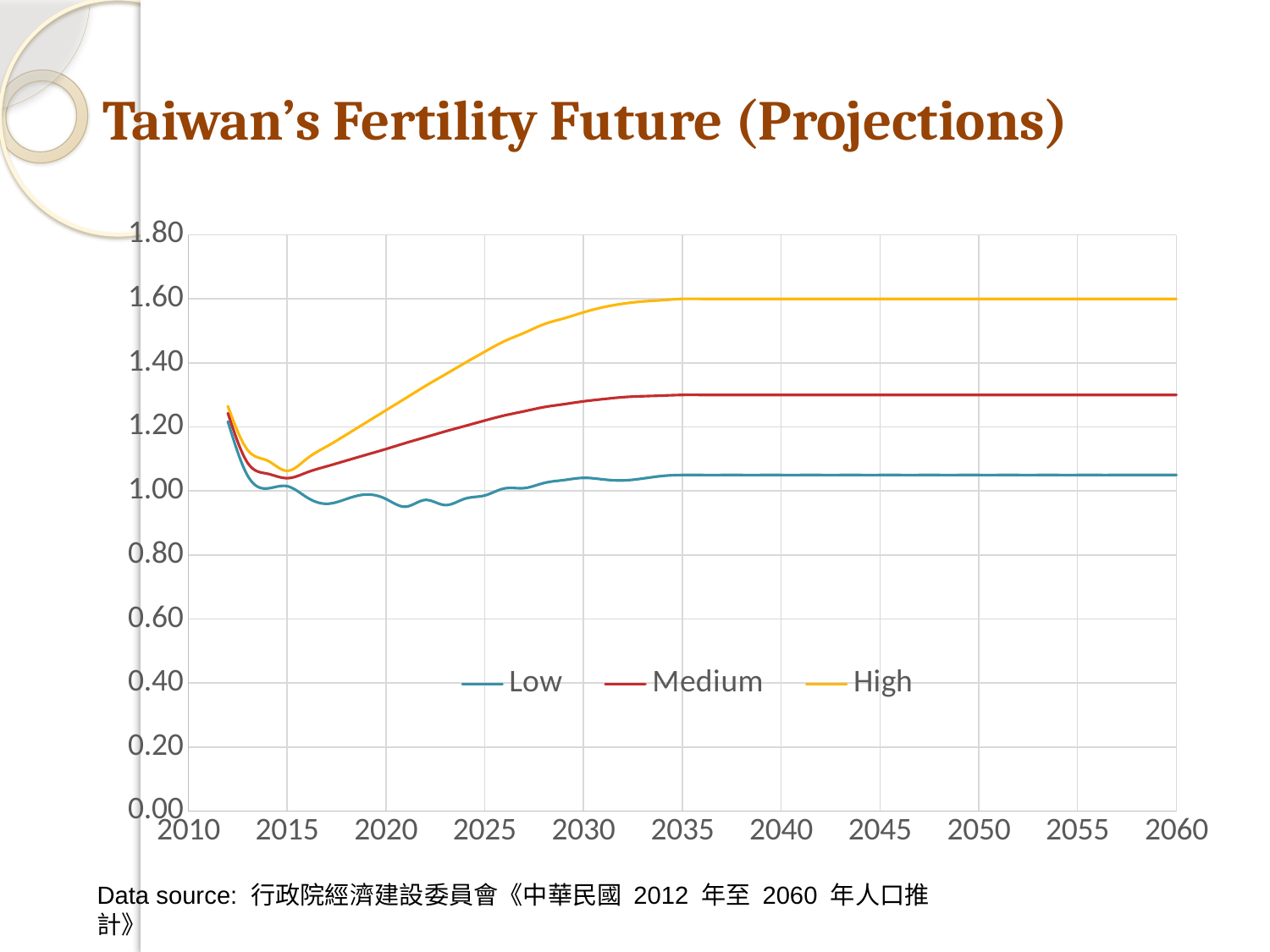
Is the value of the Medium series in 2015 greater or less than 1.20? less What are the three series named in the legend? Low, Medium, High What kind of chart is shown on the slide? line chart Which series has the lowest value in 2030? Low Is the value of the High series in 2060 greater or less than 1.40? greater Is the value of the Low series in 2060 greater or less than 1.20? less Which series has the highest value in 2040? High What is the title of the chart? Taiwan's Fertility Future (Projections) How many series does the legend list? 3 In 2050, which series is higher, High or Low? High Does the High series rise or fall between 2015 and 2035? rise